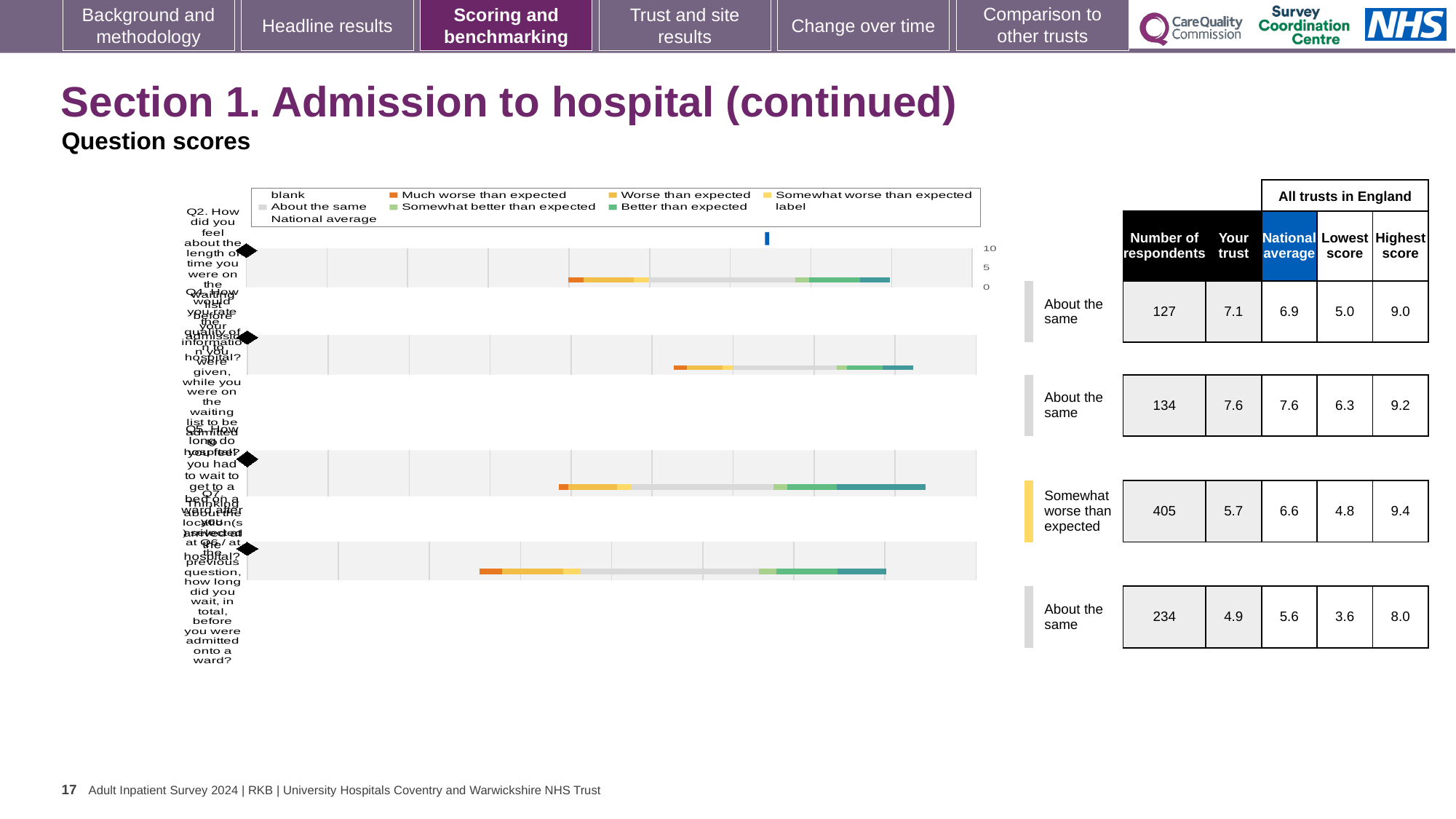
What kind of chart is shown on the slide? Bar chart How many question bars are plotted in the chart? 4 In the table, what is the number of respondents for the third row (rated 'Somewhat worse than expected')? 405 How many of the four questions are rated 'About the same'? 3 What is the lowest 'Your trust' score shown in the table? 4.9 Which benchmark rating is given to the question with 405 respondents? Somewhat worse than expected In the first row of the table, which is larger: the 'Your trust' score or the national average? Your trust (7.1) Which row of the table has the highest number of respondents? The third row (405) What is the lowest score for the row with 134 respondents? 6.3 In the table, what is the 'Your trust' score for the row with 127 respondents? 7.1 In the third row of the table, what is the difference between the national average (6.6) and the trust score (5.7)? 0.9 What is the highest score for the fourth row of the table (234 respondents)? 8.0